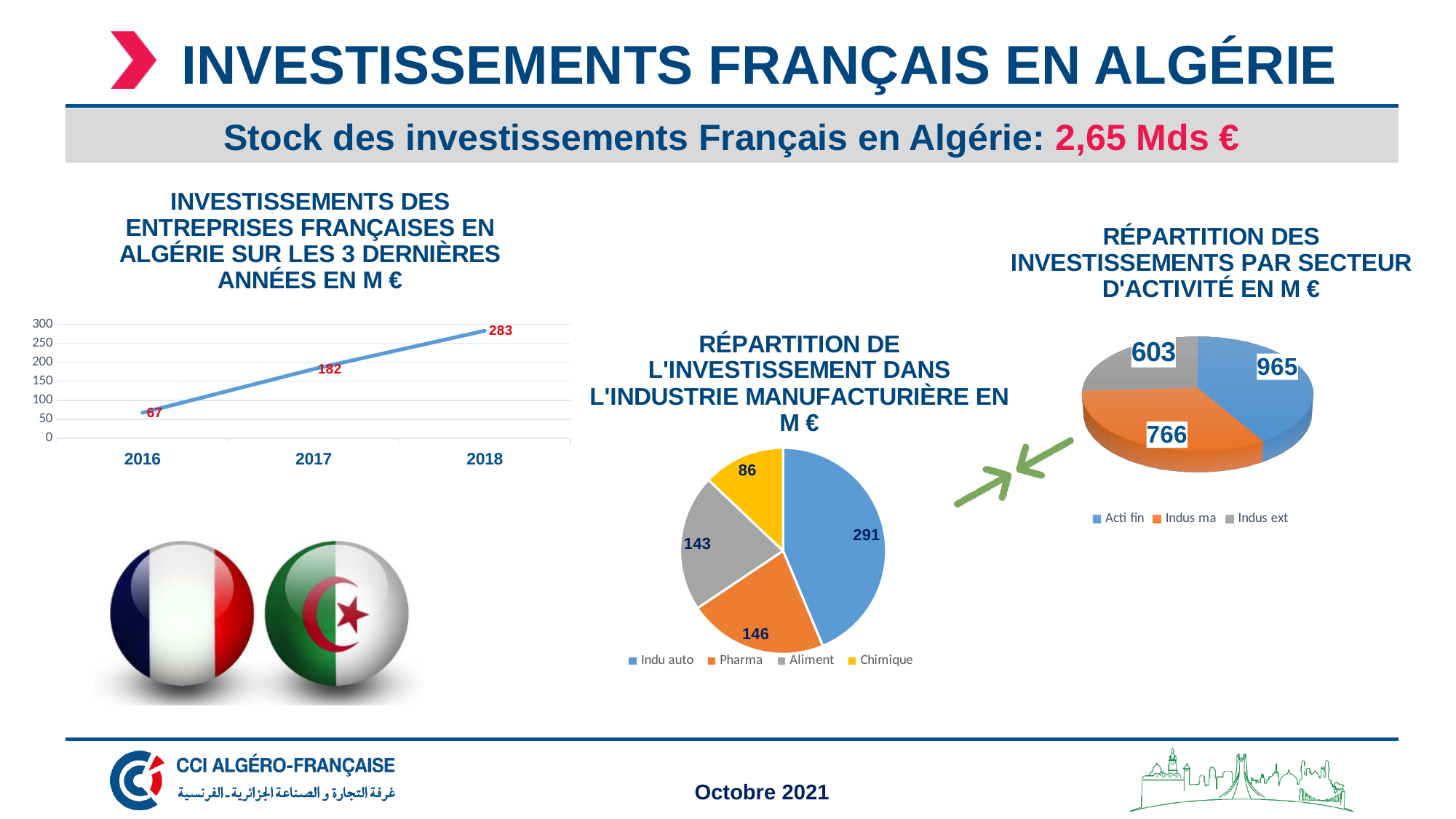
In the line chart on the left, do the values rise or fall from 2016 to 2018? rise In the pie chart 'Répartition de l'investissement dans l'industrie manufacturière', which category has the smallest value? Chimique In the pie chart 'Répartition de l'investissement dans l'industrie manufacturière', how many categories does the legend list? 4 How many years are plotted in the line chart on the left? 3 In the pie chart 'Répartition de l'investissement dans l'industrie manufacturière', what is the value for Pharma? 146 In the pie chart 'Répartition des investissements par secteur d'activité', which colour represents Indus ext? grey In the line chart on the left, what was the investment value in 2017? 182 In the line chart on the left, what is the difference between the 2018 and 2016 values? 216 In the pie chart 'Répartition des investissements par secteur d'activité', which sector has the largest value? Acti fin What type of chart is the chart on the left showing investments over the last 3 years? line chart In the line chart on the left, what was the investment value in 2018? 283 In the pie chart 'Répartition des investissements par secteur d'activité', what is the difference between Indus ma and Indus ext? 163